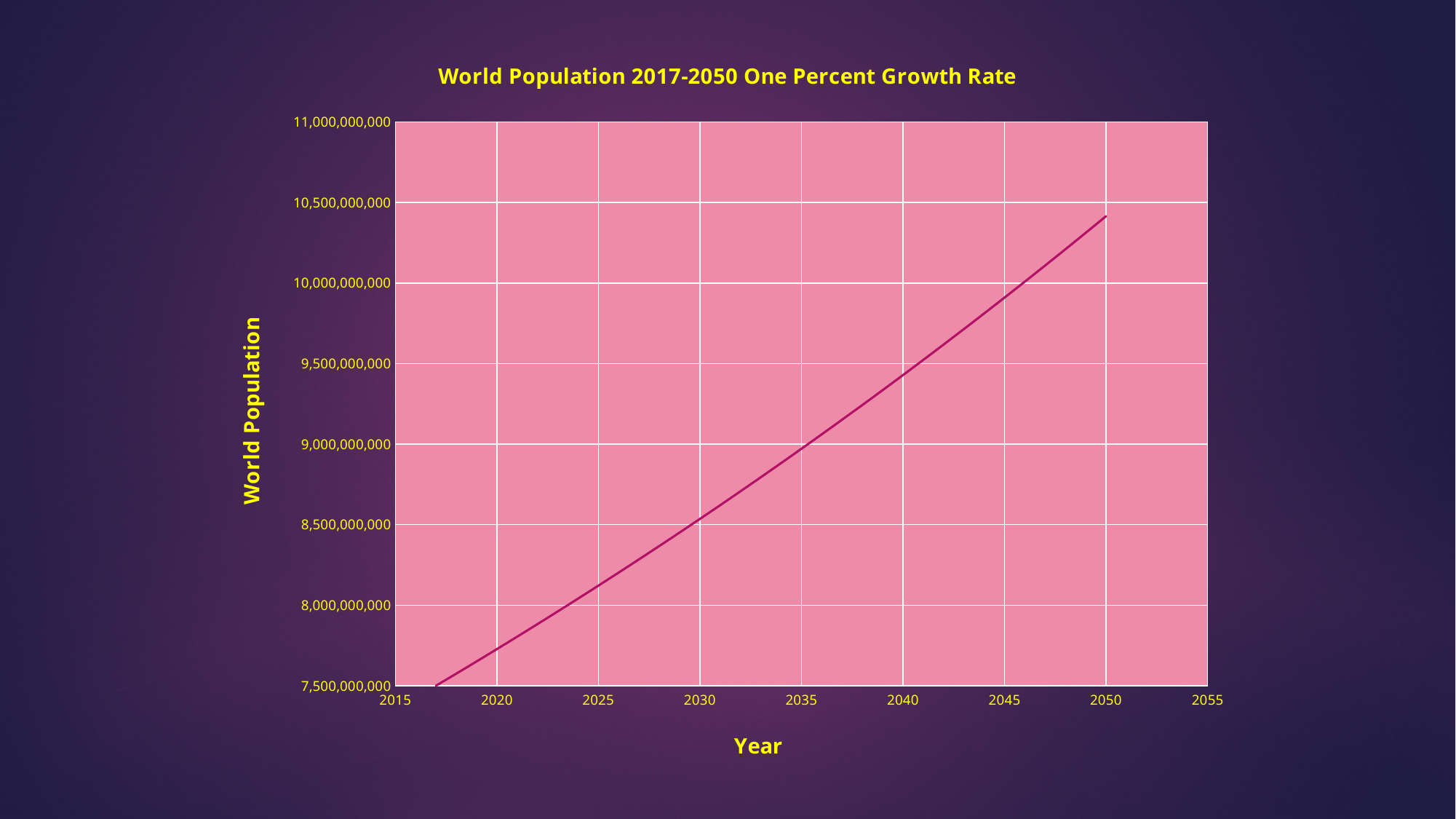
What is the label of the vertical axis? World Population What kind of chart is shown on the slide? line chart Is the world population value for 2045 greater or less than 9,500,000,000? greater Is the world population value for 2050 greater or less than 10,500,000,000? less Which year has the higher plotted world population, 2025 or 2045? 2045 Do the plotted values rise or fall as the year increases along the x axis? rise Is the world population value for 2040 greater or less than 9,500,000,000? less What is the title of the chart? World Population 2017-2050 One Percent Growth Rate In which year shown on the line is the world population lowest? 2017